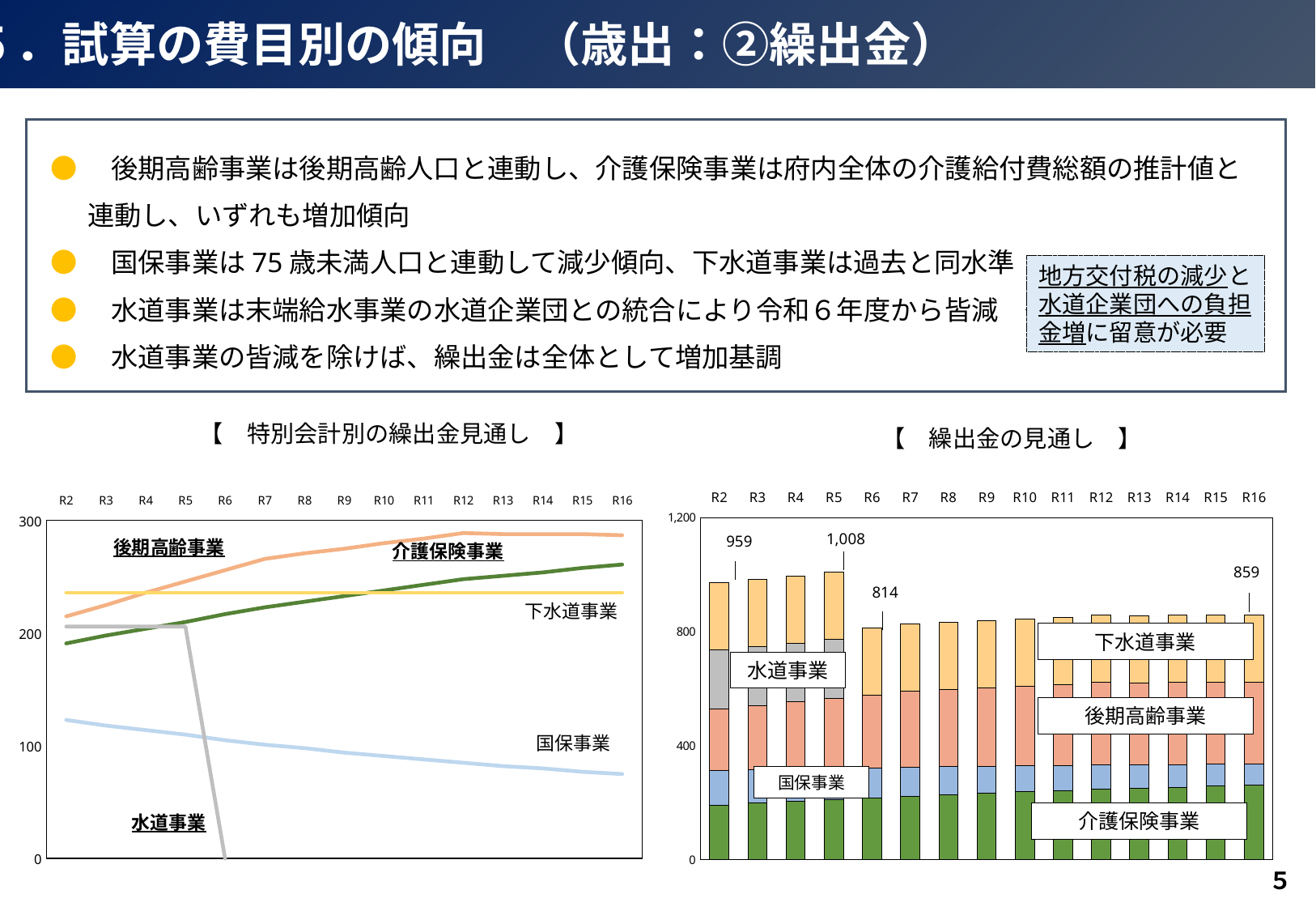
In the right chart 繰出金の見通し, what is the total value of the stacked bar for R6? 814 In the left chart 特別会計別の繰出金見通し, which series drops to 0 at R6? 水道事業 What kind of chart is the left chart titled 特別会計別の繰出金見通し? line chart In the left chart 特別会計別の繰出金見通し, is the value for 下水道事業 at R2 greater or less than 200? greater In the right chart 繰出金の見通し, what is the difference between the labelled totals for R5 and R2? 49 In the left chart 特別会計別の繰出金見通し, does the 国保事業 line rise or fall from R2 to R16? fall In the right chart 繰出金の見通し, what is the total value of the stacked bar for R16? 859 In the right chart 繰出金の見通し, what is the total value of the stacked bar for R2? 959 How many years (categories) are shown on the x axis of the left chart 特別会計別の繰出金見通し? 15 What kind of chart is the right chart titled 繰出金の見通し? bar chart In the right chart 繰出金の見通し, which labelled total is larger, R2 or R16? R2